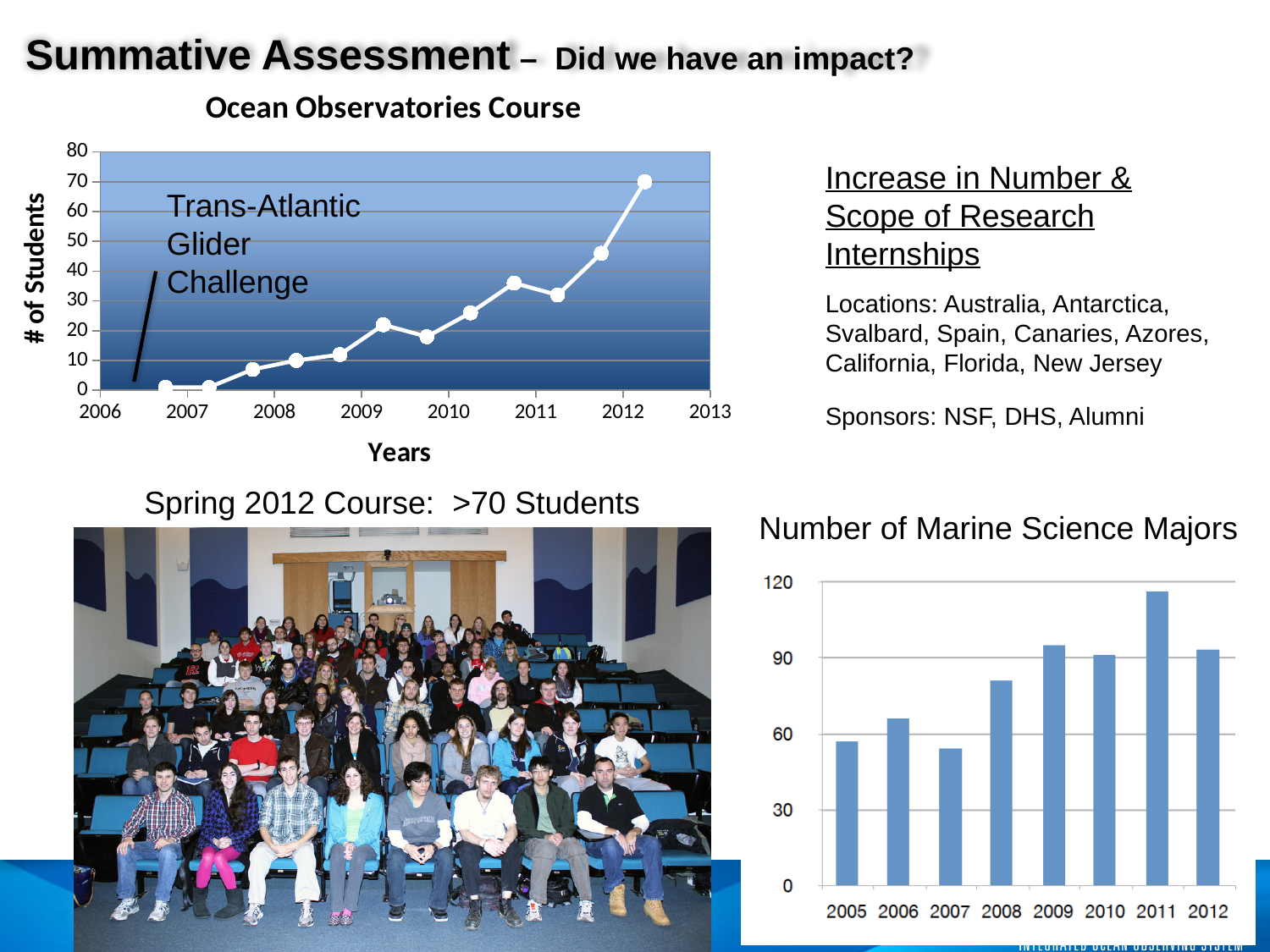
In the "Number of Marine Science Majors" chart, which is larger, the value for 2006 or the value for 2008? 2008 In the "Ocean Observatories Course" chart, is the last plotted value (in 2012) greater or less than 60? greater In the "Ocean Observatories Course" chart, do the number of students generally rise or fall from 2006 to 2012? rise What type of chart is the "Ocean Observatories Course" chart? line chart How many years are shown on the x axis of the "Number of Marine Science Majors" chart? 8 In the "Number of Marine Science Majors" chart, which year has the highest number of majors? 2011 In the "Number of Marine Science Majors" chart, is the value for 2011 greater or less than 90? greater What type of chart is the "Number of Marine Science Majors" chart? bar chart In the "Number of Marine Science Majors" chart, is the value for 2008 greater or less than 60? greater In the "Number of Marine Science Majors" chart, which is larger, the value for 2011 or the value for 2012? 2011 What is the y-axis title of the "Ocean Observatories Course" chart? # of Students